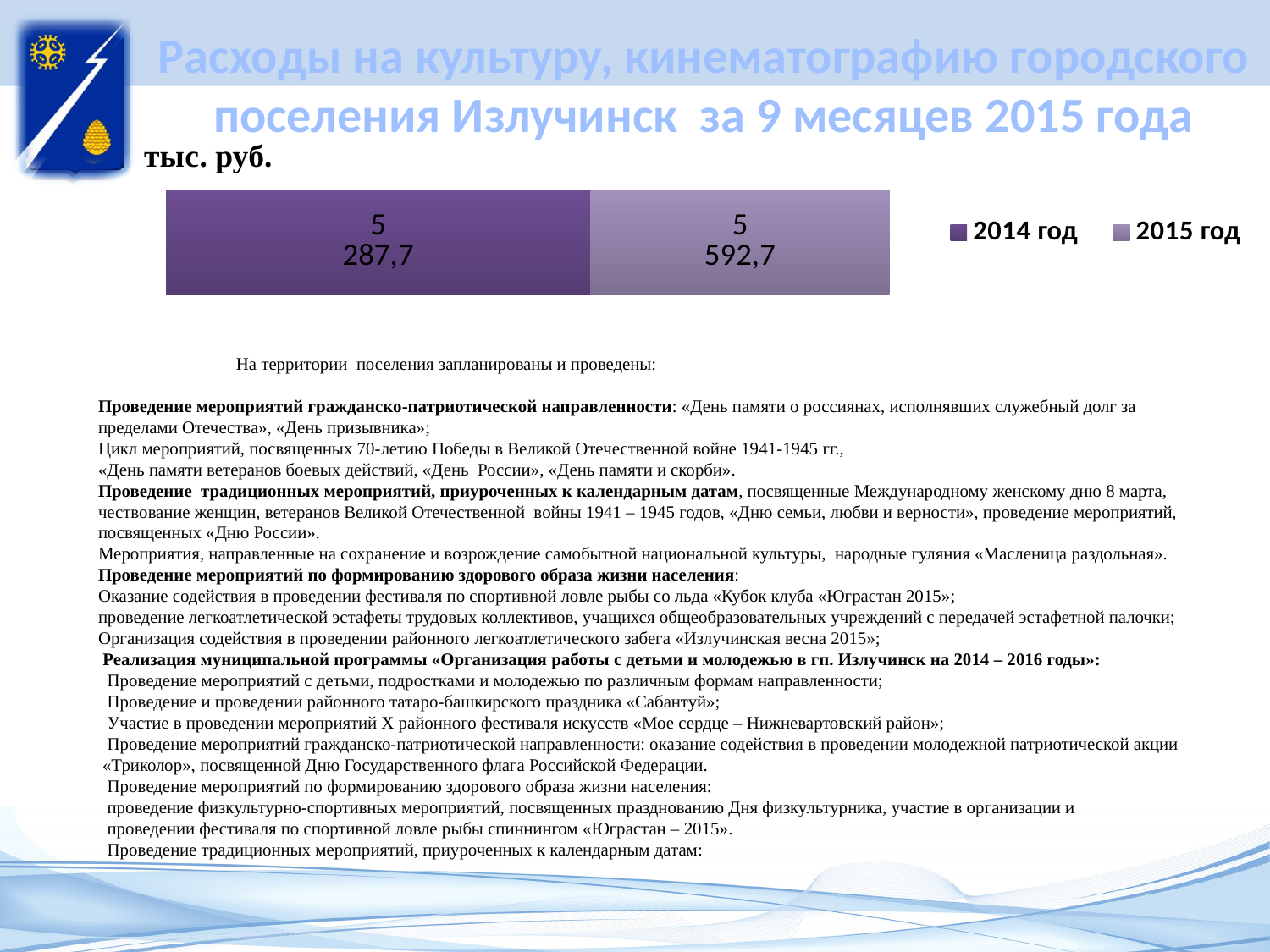
What is the value for 2014 год on the chart? 5 287,7 Which year has the higher value, 2014 год or 2015 год? 2015 год Which series has the lowest value on the chart? 2014 год What is the total of the two segments in the stacked bar? 10 880,4 Do the values rise or fall from 2014 год to 2015 год? Rise What is the value for 2015 год on the chart? 5 592,7 How many series does the legend list? 2 What kind of chart is shown on the slide? Bar chart What unit is stated for the chart values? тыс. руб. What is the difference between the values for 2015 год and 2014 год? 305 Which series has the highest value on the chart? 2015 год Which legend entry is shown in the darker purple colour? 2014 год